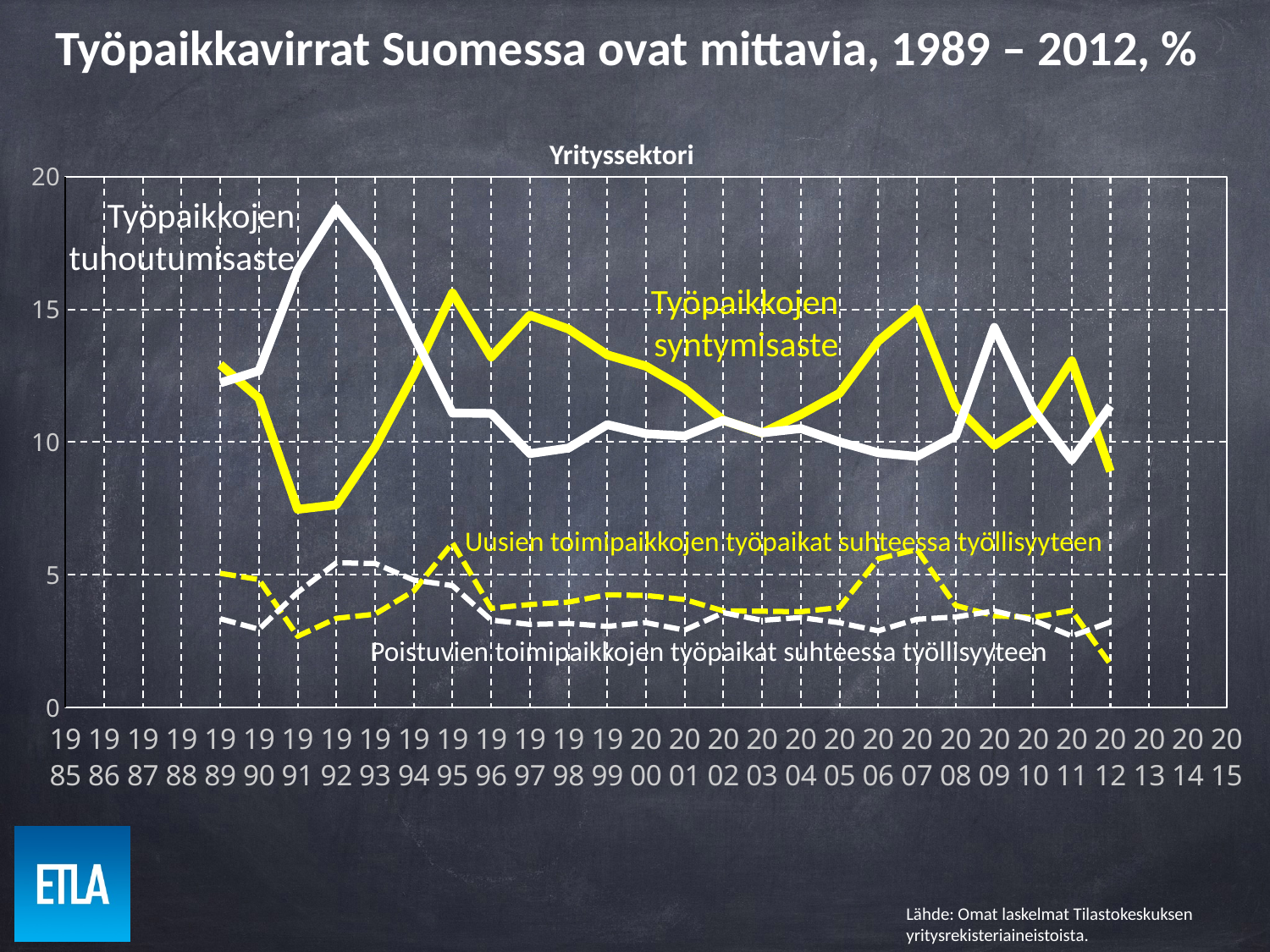
In 1992, which is larger: Työpaikkojen tuhoutumisaste or Työpaikkojen syntymisaste? Työpaikkojen tuhoutumisaste What is the title printed above the chart's plot area? Yrityssektori What colour is the Työpaikkojen syntymisaste line? yellow In which year does the Työpaikkojen tuhoutumisaste line reach its highest value? 1992 Is the value of Työpaikkojen syntymisaste in 1991 greater or less than 10? less What kind of chart is shown on the slide? line chart How many data series are labelled on the chart? 4 In 2007, which is larger: Työpaikkojen syntymisaste or Työpaikkojen tuhoutumisaste? Työpaikkojen syntymisaste Is the value of Poistuvien toimipaikkojen työpaikat suhteessa työllisyyteen in 2012 greater or less than 5? less Is the value of Uusien toimipaikkojen työpaikat suhteessa työllisyyteen in 2007 greater or less than 5? greater Does the Työpaikkojen tuhoutumisaste line rise or fall from 1992 to 1997? fall